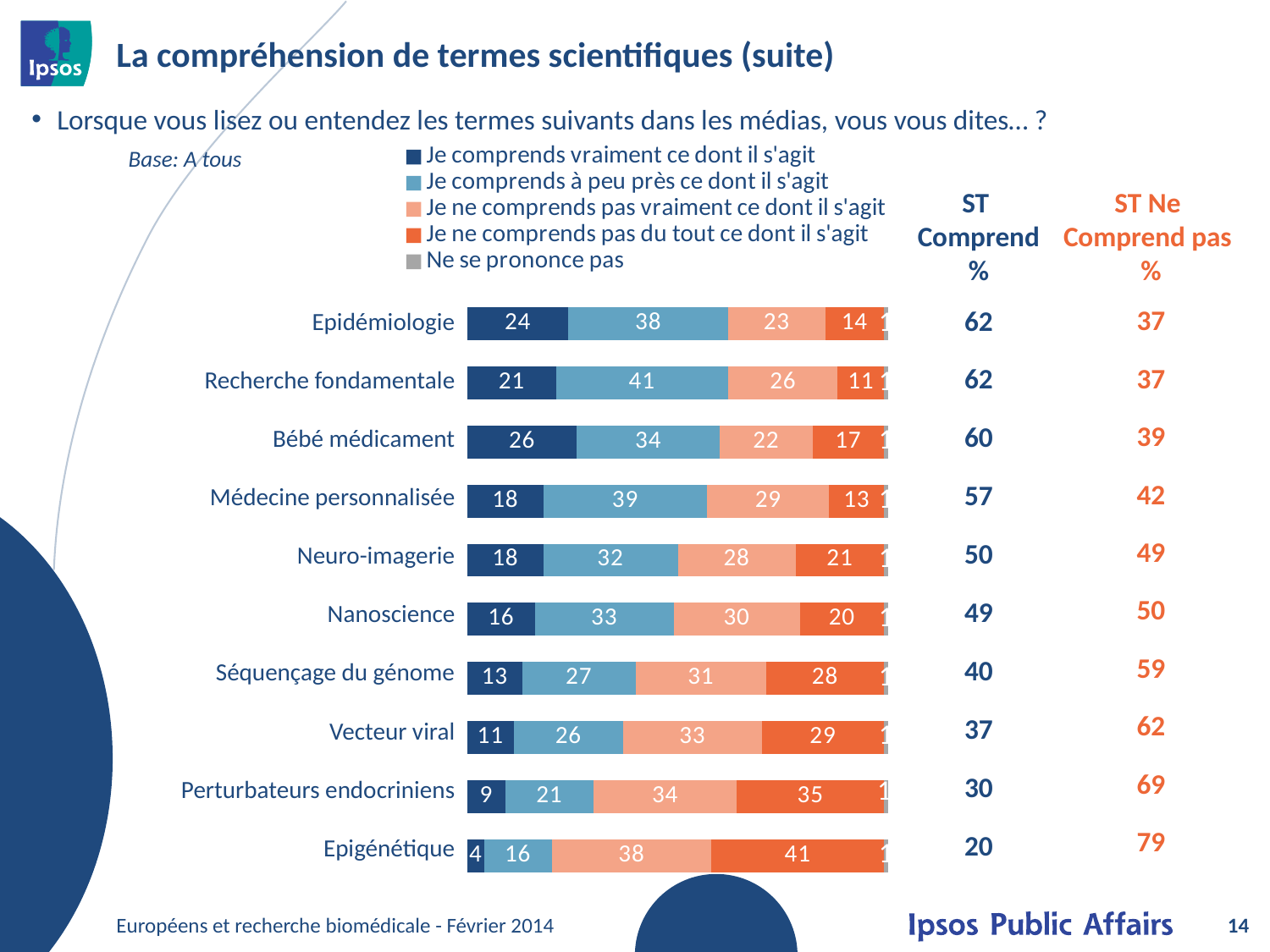
Which category has the highest value for "Je comprends vraiment ce dont il s'agit"? Bébé médicament What is the value of "Je comprends à peu près ce dont il s'agit" for Recherche fondamentale? 41 How many series does the legend list? 5 How many categories (scientific terms) are plotted in the chart? 10 What is the value of "Je ne comprends pas du tout ce dont il s'agit" for Epigénétique? 41 Which category has the lowest value for "Je comprends vraiment ce dont il s'agit"? Epigénétique Which is larger: the "Je ne comprends pas vraiment ce dont il s'agit" value for Nanoscience or for Neuro-imagerie? Nanoscience What is the value of "Je comprends vraiment ce dont il s'agit" for Bébé médicament? 26 What is the difference between the "Je ne comprends pas du tout ce dont il s'agit" values for Epigénétique and Epidémiologie? 27 What kind of chart is shown on the slide? stacked bar chart What is the total of the stacked bar for Vecteur viral? 100 What colour represents "Je ne comprends pas du tout ce dont il s'agit" in the chart? orange